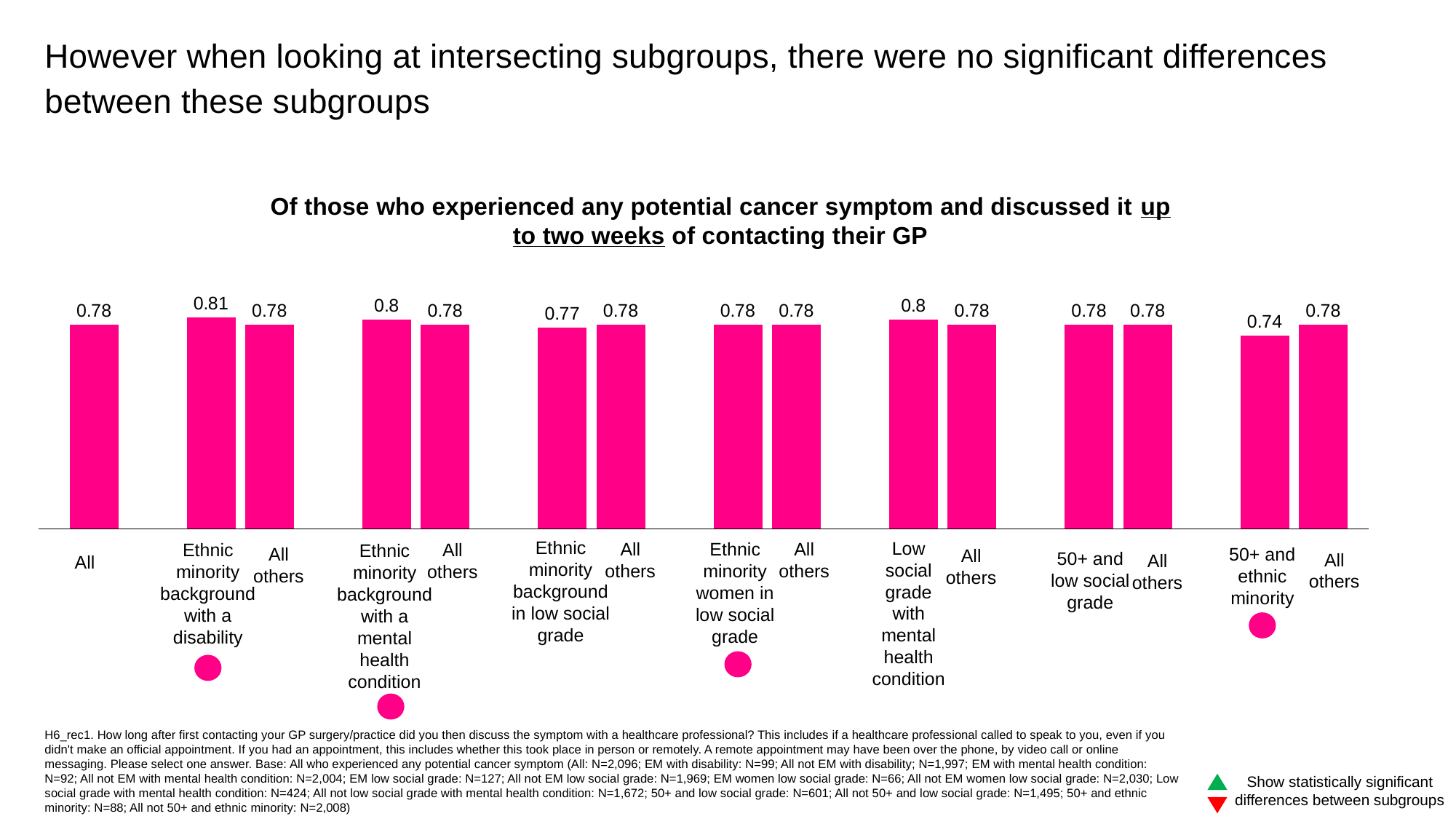
What is the value for 'Ethnic minority background with a disability'? 0.81 How many bars are plotted in the chart? 15 Which category has the highest value? Ethnic minority background with a disability What is the value for 'Ethnic minority background in low social grade'? 0.77 Which is larger: the value for 'Ethnic minority background with a mental health condition' or the value for '50+ and ethnic minority'? Ethnic minority background with a mental health condition What type of chart is shown on the slide? Bar chart What is the value for 'Low social grade with mental health condition'? 0.8 What is the difference between the value for 'All' and the value for '50+ and ethnic minority'? 0.04 What is the difference between the value for 'Ethnic minority background with a disability' and the value for 'All'? 0.03 Which category has the lowest value? 50+ and ethnic minority What is the value for '50+ and ethnic minority'? 0.74 What is the value for the 'All' category? 0.78